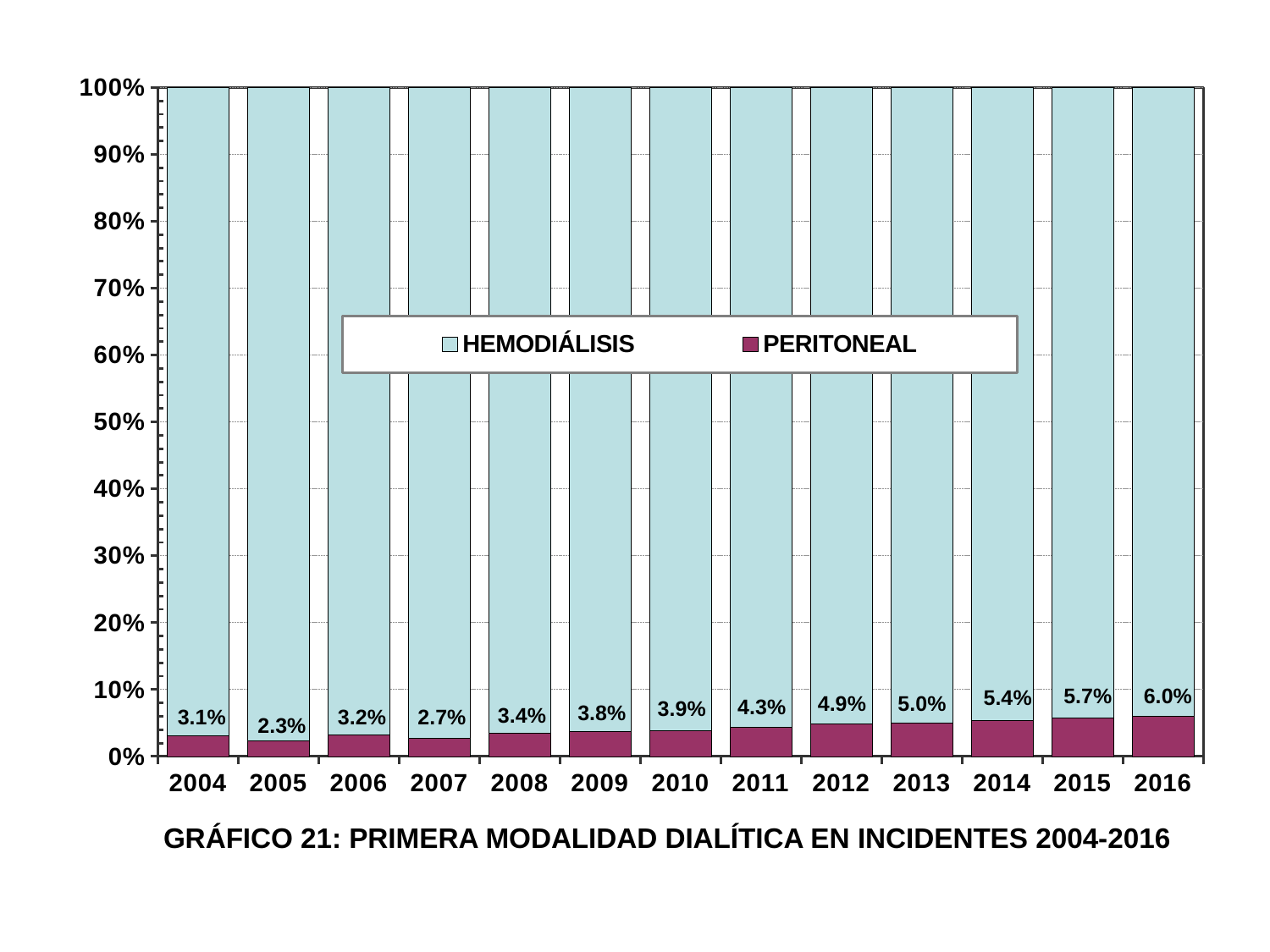
What is the PERITONEAL value for 2004? 3.1% Which year has a larger PERITONEAL value, 2009 or 2013? 2013 How many years are shown on the x axis? 13 Is the HEMODIÁLISIS value for 2010 greater or less than 90%? greater What kind of chart is shown on the slide? Stacked bar chart Which year has the lowest PERITONEAL value? 2005 Which year has the highest PERITONEAL value? 2016 How many series does the legend list? 2 What is the PERITONEAL value for 2016? 6.0% Does the PERITONEAL value rise or fall from 2007 to 2016? Rise What is the PERITONEAL value for 2012? 4.9% What is the difference between the PERITONEAL values for 2016 and 2004? 2.9%